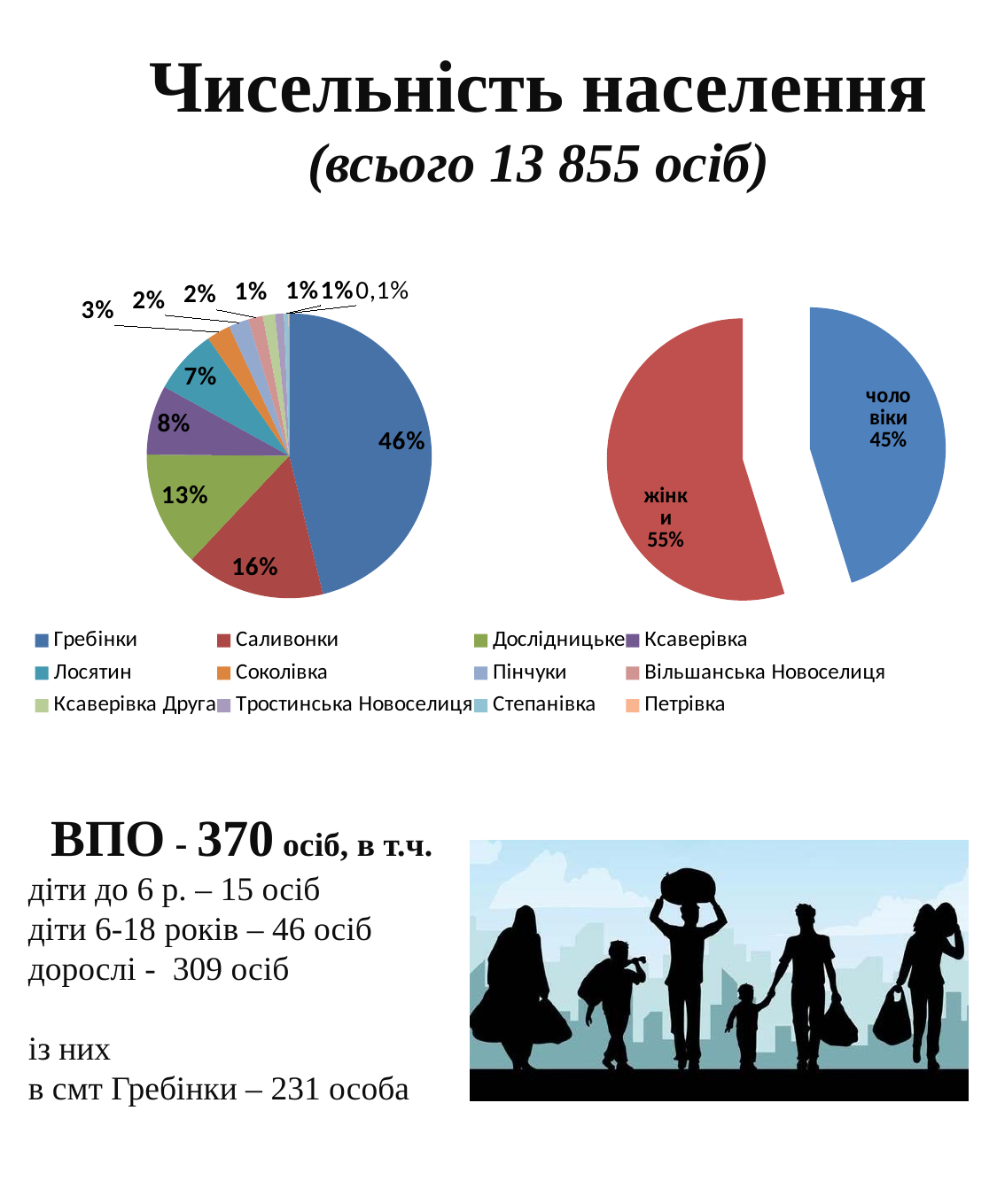
In the left pie chart, what share of the population is Гребінки? 46% In the right pie chart, what share is чоловіки? 45% In the right pie chart, what share is жінки? 55% What kind of chart is the left chart on the slide? pie chart In the left pie chart, which settlement has the largest share? Гребінки In the right pie chart, which is larger, the share of жінки or the share of чоловіки? жінки In the left pie chart, what is the difference between the shares of Гребінки and Саливонки? 30% How many settlements does the legend of the left pie chart list? 12